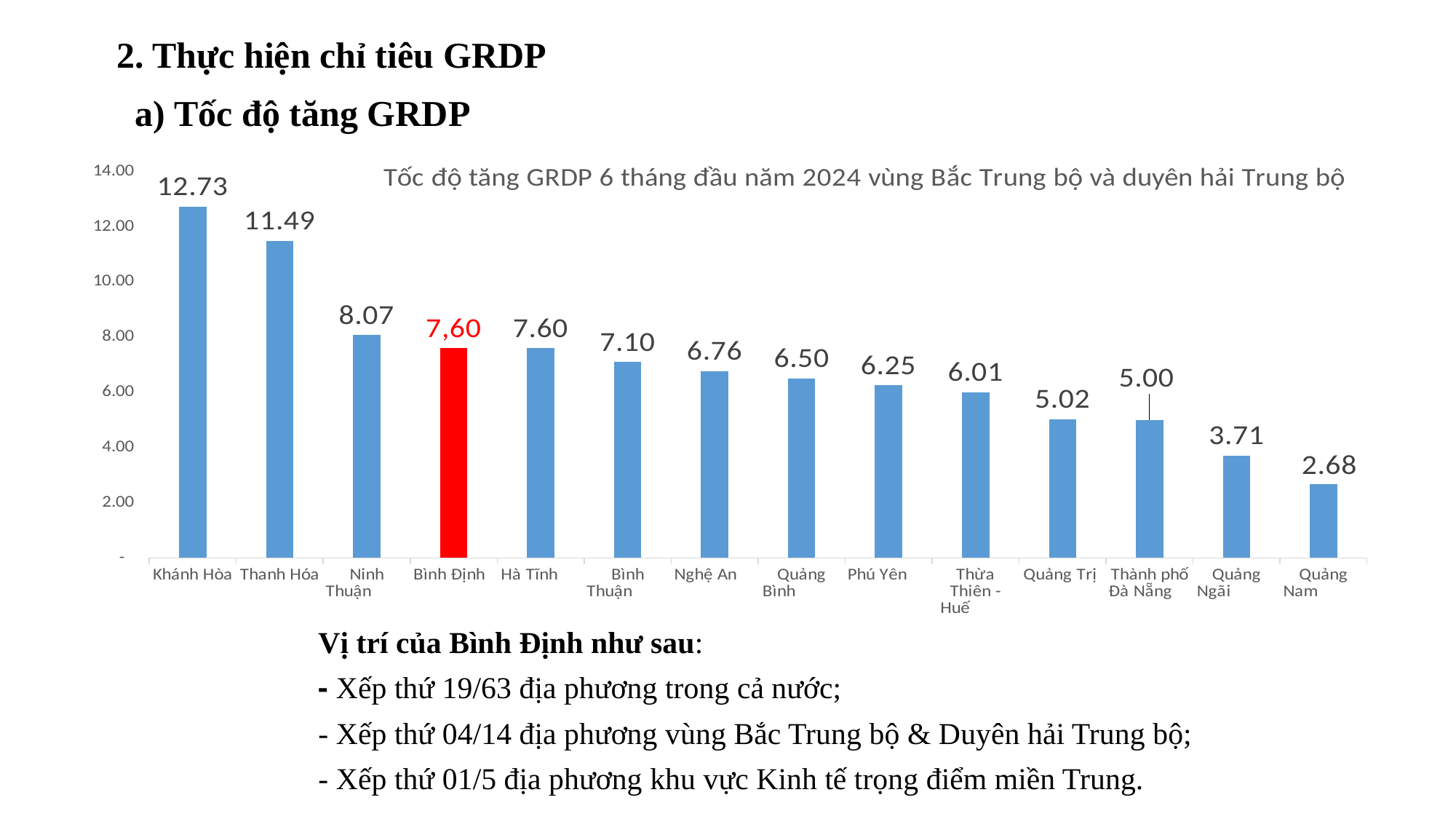
Is the value for Ninh Thuận greater or less than 8.00? greater Which province has the highest GRDP growth rate? Khánh Hòa What is the difference between the values for Khánh Hòa and Thanh Hóa? 1.24 What is the value for Khánh Hòa? 12.73 What is the value for Bình Định? 7,60 Which province has the lowest GRDP growth rate? Quảng Nam Which bar is highlighted in red? Bình Định What is the value for Quảng Nam? 2.68 How many provinces are shown in the chart? 14 What kind of chart is shown on the slide? Bar chart Which is larger, the value for Nghệ An or the value for Quảng Bình? Nghệ An What is the value for Thành phố Đà Nẵng? 5.00